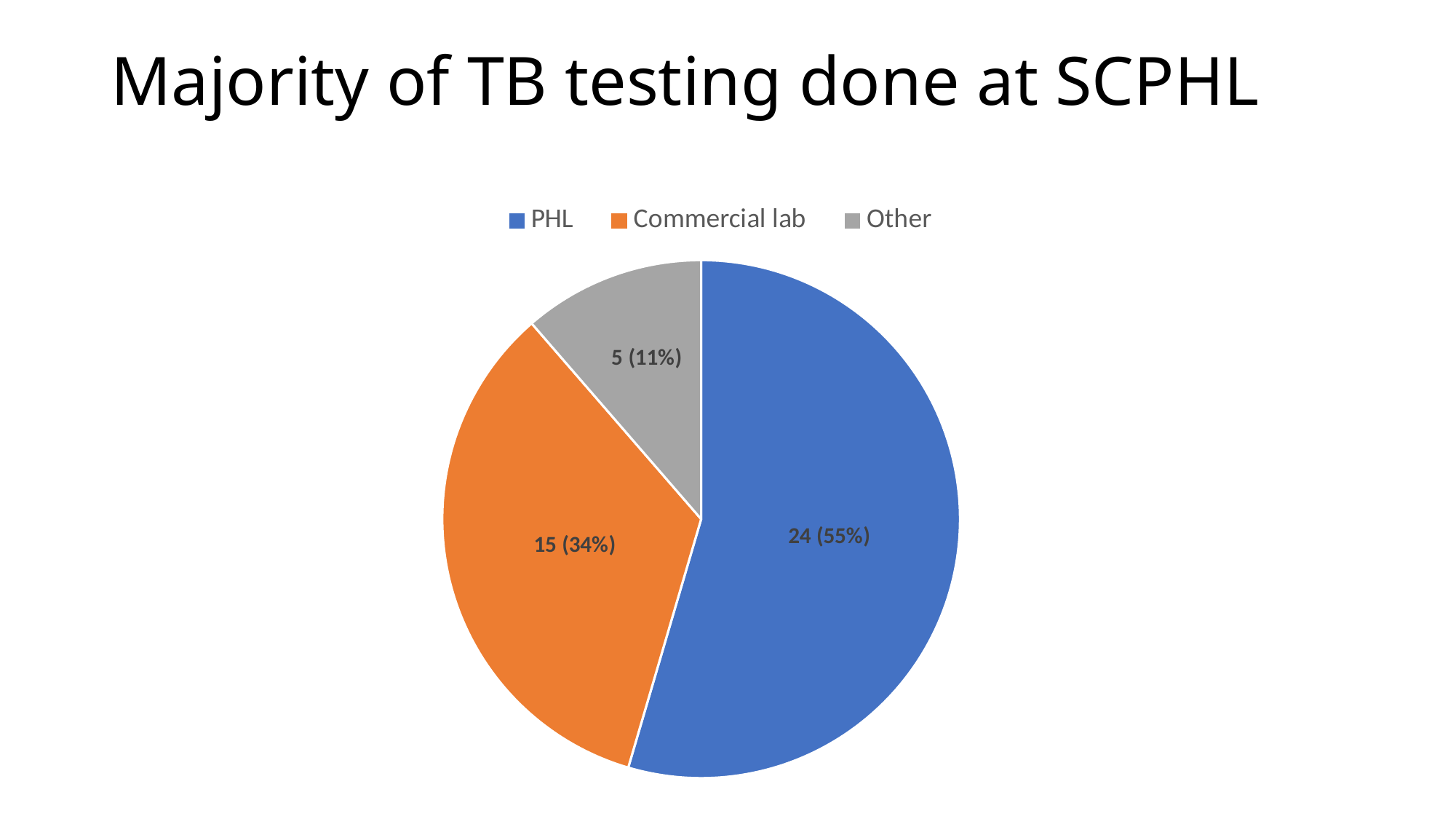
What is the difference between the PHL count and the Commercial lab count? 9 What is the value for Other? 5 (11%) What kind of chart is shown on the slide? pie chart How many categories does the pie chart have? 3 What is the value for Commercial lab? 15 (34%) What is the value for PHL? 24 (55%) What share of the pie does Commercial lab represent? 34% What share of the pie does PHL represent? 55% Which category has the largest slice? PHL Which is larger, the Commercial lab slice or the Other slice? Commercial lab Which category has the smallest slice? Other What is the title of the slide? Majority of TB testing done at SCPHL